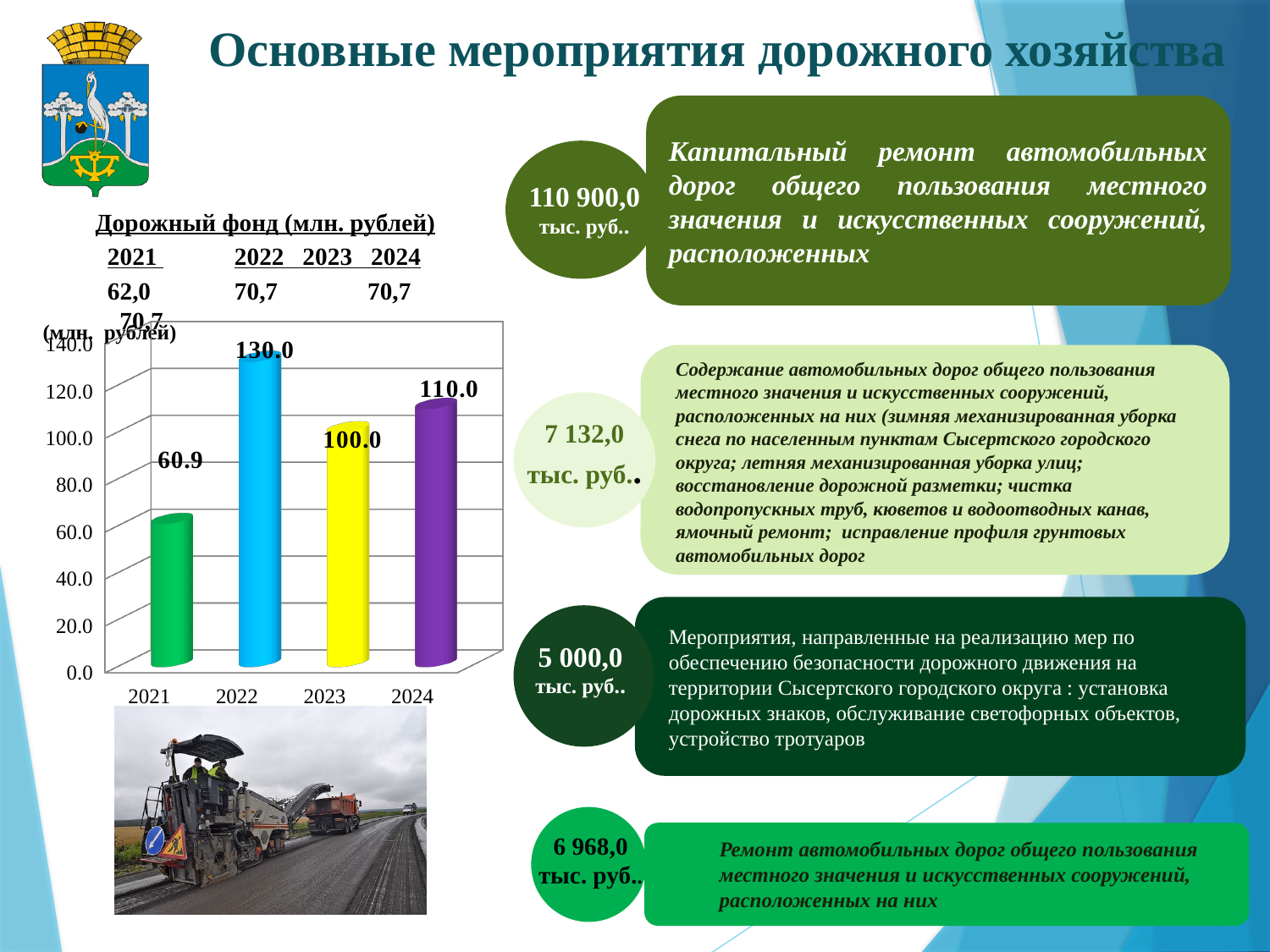
What is the title of the chart on the slide? Дорожный фонд (млн. рублей) What is the difference between the values for 2022 and 2021 in the bar chart? 69.1 What kind of chart is shown on the slide? bar chart What is the value for 2021 in the bar chart? 60.9 Which year has the lowest value in the bar chart? 2021 What is the value for 2024 in the bar chart? 110.0 What is the value for 2023 in the bar chart? 100.0 Which year has the highest value in the bar chart? 2022 What is the difference between the values for 2024 and 2023 in the bar chart? 10.0 What is the value for 2022 in the bar chart? 130.0 Which is larger in the bar chart, the value for 2023 or the value for 2024? 2024 How many years (categories) are shown in the bar chart? 4